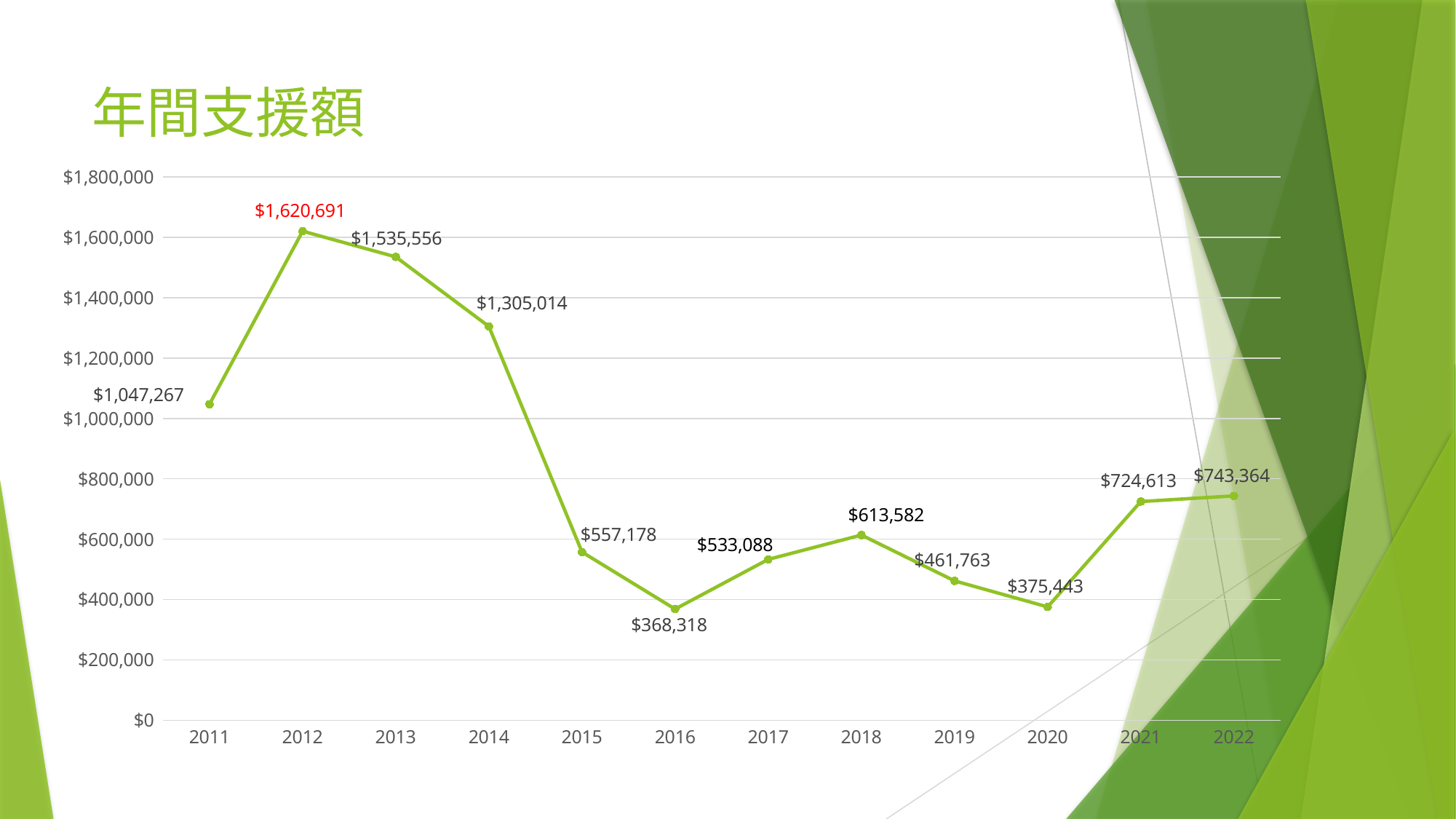
What is the value for 2012? $1,620,691 What kind of chart is shown on the slide? line chart What is the value for 2016? $368,318 How many years are plotted on the chart? 12 What is the difference between the values for 2022 and 2021? $18,751 Which year has the highest value? 2012 Is the value for 2014 greater or less than $1,200,000? greater Do the values rise or fall from 2012 to 2016? fall What is the value for 2022? $743,364 What is the difference between the values for 2012 and 2011? $573,424 Which is larger, the value for 2015 or the value for 2017? 2015 Which year has the lowest value? 2016